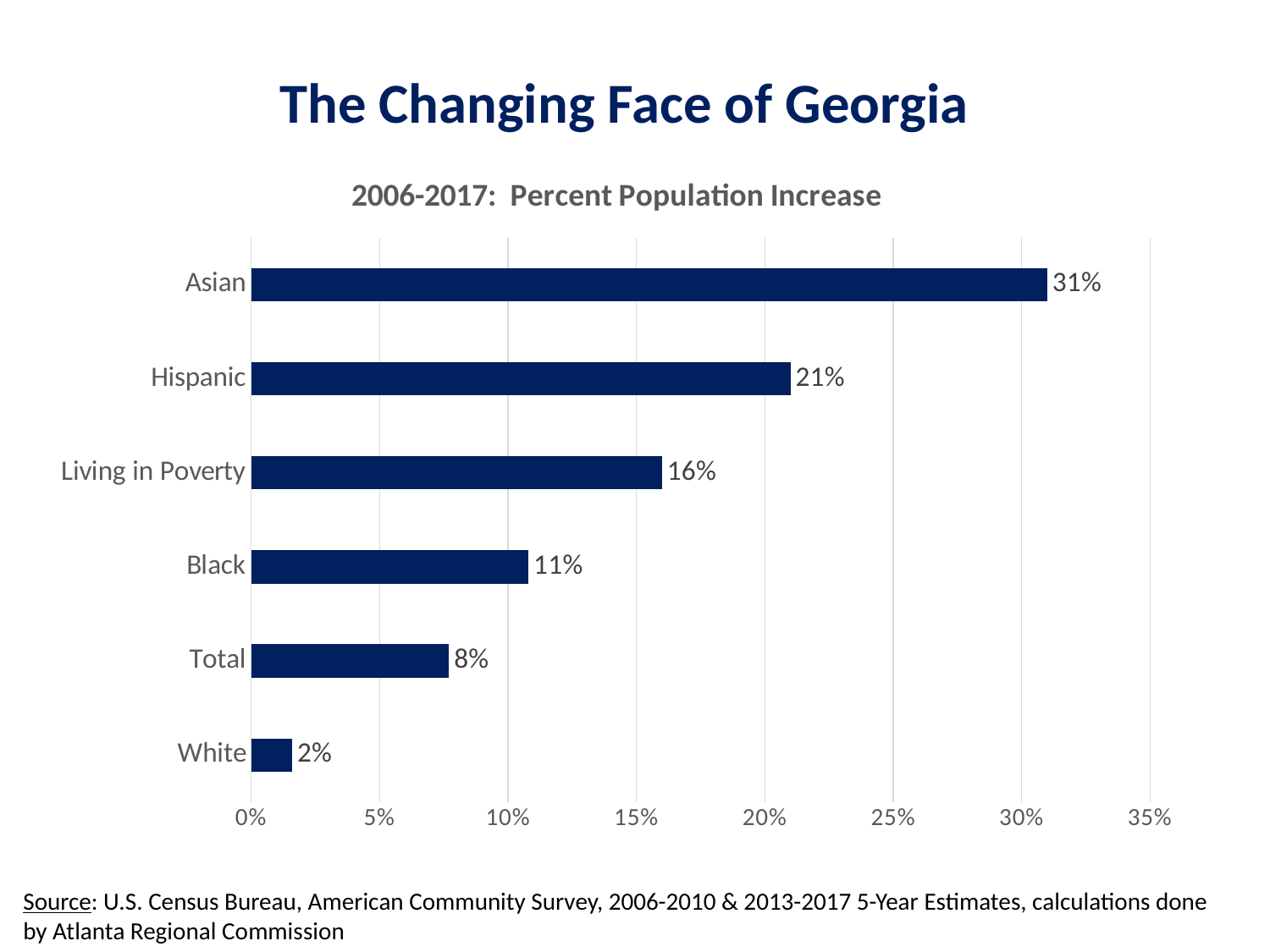
Which category has the highest percent population increase? Asian What is the percent population increase for Asian? 31% What is the percent population increase for White? 2% Is the value for Living in Poverty greater or less than 15%? greater What is the percent population increase for Living in Poverty? 16% How many categories are shown in the chart? 6 Which category has the lowest percent population increase? White Which has a larger percent population increase, Black or Total? Black What is the title of the chart? 2006-2017: Percent Population Increase What is the difference between the percent population increase for Asian and Hispanic? 10% What kind of chart is shown on the slide? Bar chart What is the percent population increase for Hispanic? 21%